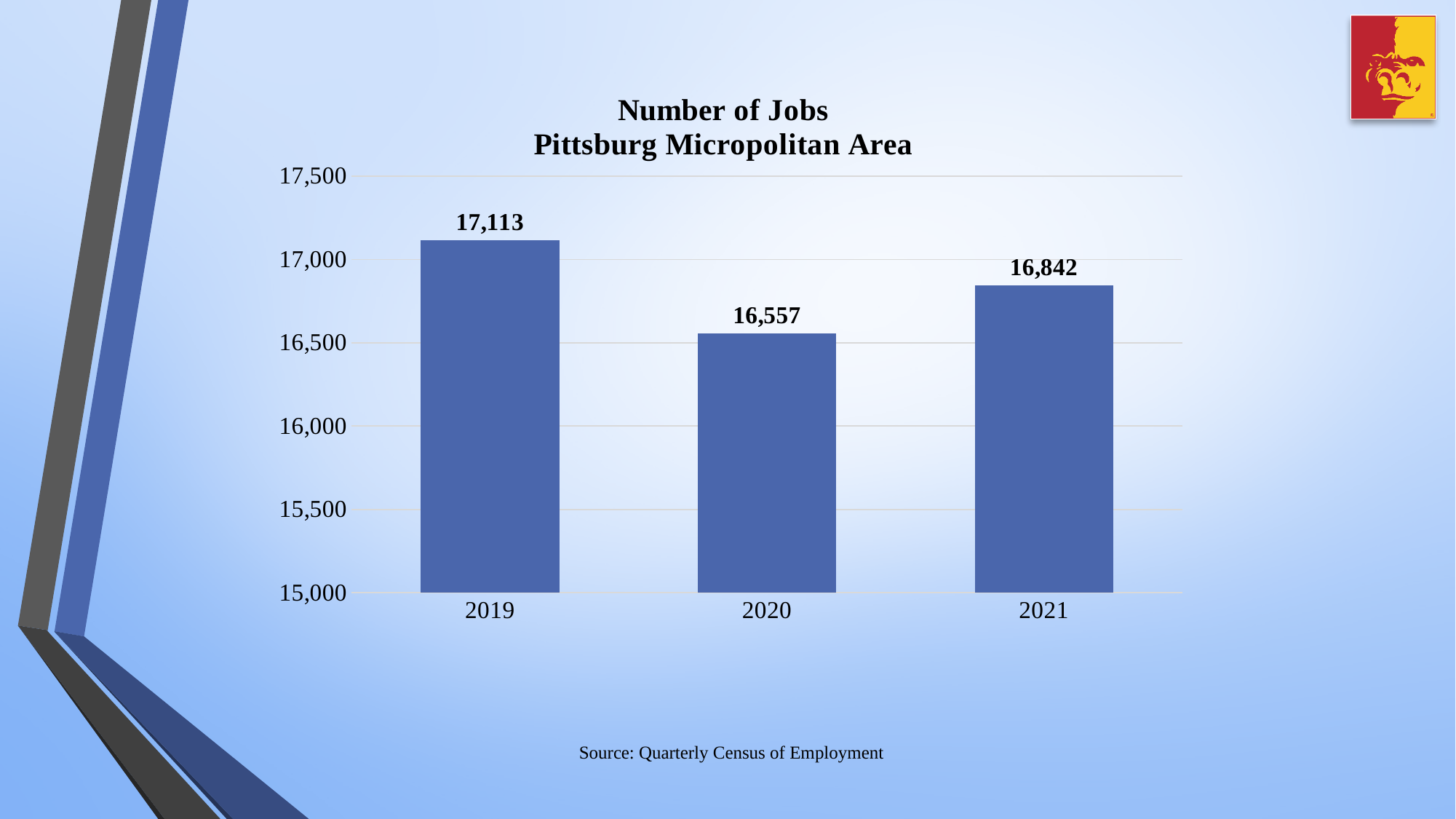
What is the number of jobs in 2020? 16,557 What is the number of jobs in 2019? 17,113 What kind of chart is shown on the slide? bar chart Which year has more jobs, 2020 or 2021? 2021 What is the number of jobs in 2021? 16,842 What is the title of the chart? Number of Jobs Pittsburg Micropolitan Area Which year has the highest number of jobs? 2019 Is the number of jobs in 2021 greater or less than 17,000? less How many years are shown on the chart? 3 What is the difference in the number of jobs between 2021 and 2020? 285 Which year has the lowest number of jobs? 2020 What is the difference in the number of jobs between 2019 and 2020? 556